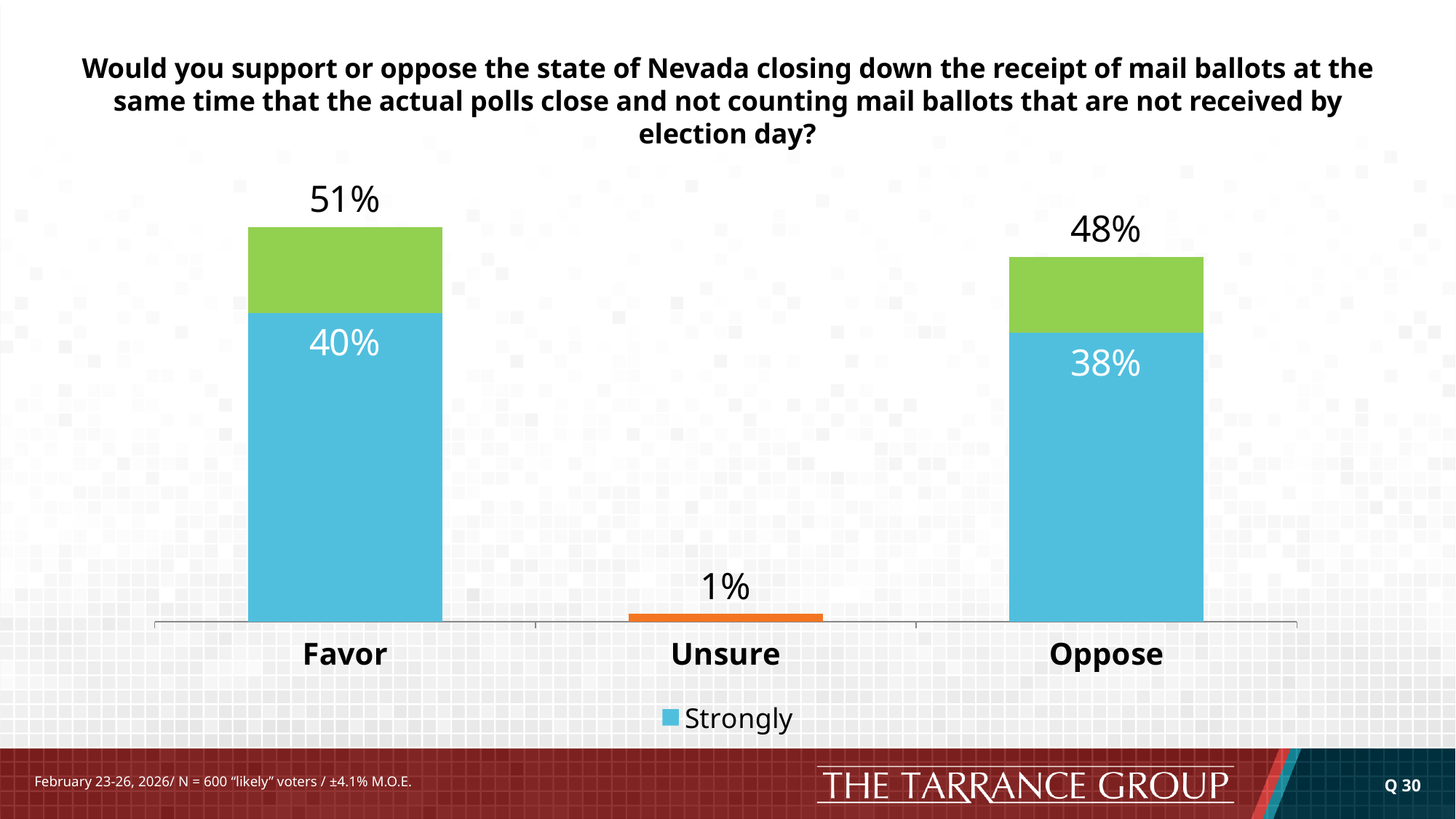
What is the value shown for Unsure? 1% What series does the legend list? Strongly What is the difference between the total for Favor and the total for Oppose? 3% What is the total value shown for Favor? 51% Which category has the lowest value? Unsure Which category has the highest total value? Favor What is the Strongly value for Oppose? 38% How many categories are shown on the x axis? 3 What kind of chart is shown on the slide? Bar chart What is the total value shown for Oppose? 48% Which is larger, the Strongly value for Favor or the Strongly value for Oppose? Favor What is the Strongly value for Favor? 40%